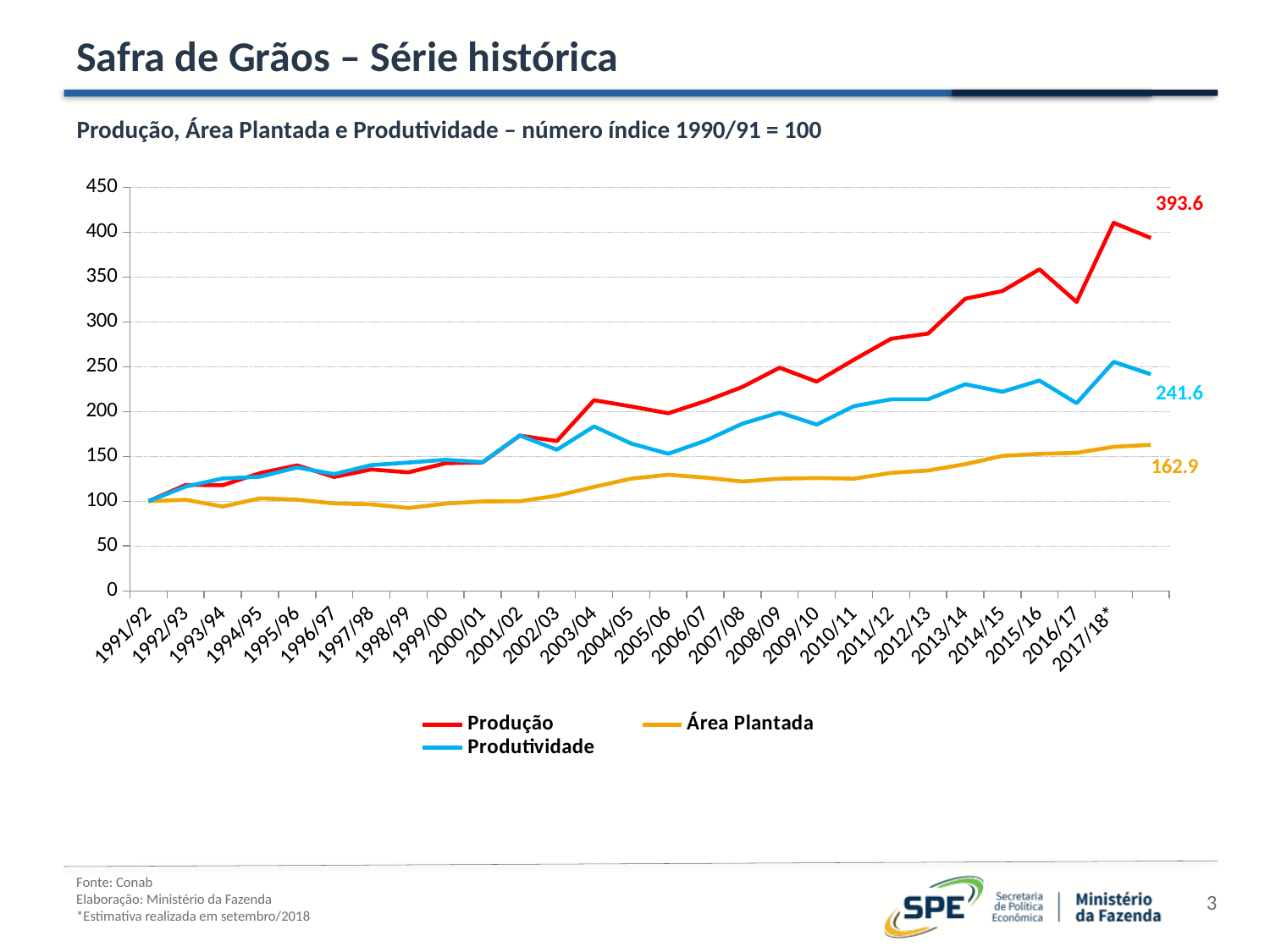
What kind of chart is shown on the slide? line chart Does the Produção series generally rise or fall from 1991/92 to 2017/18*? rise How many series does the legend list? 3 Is the value of Área Plantada for 2005/06 greater or less than 150? less Which series has the highest value in 2017/18*? Produção Is the value of Produção for 2015/16 greater or less than 350? greater Which series has the lowest value in 2017/18*? Área Plantada